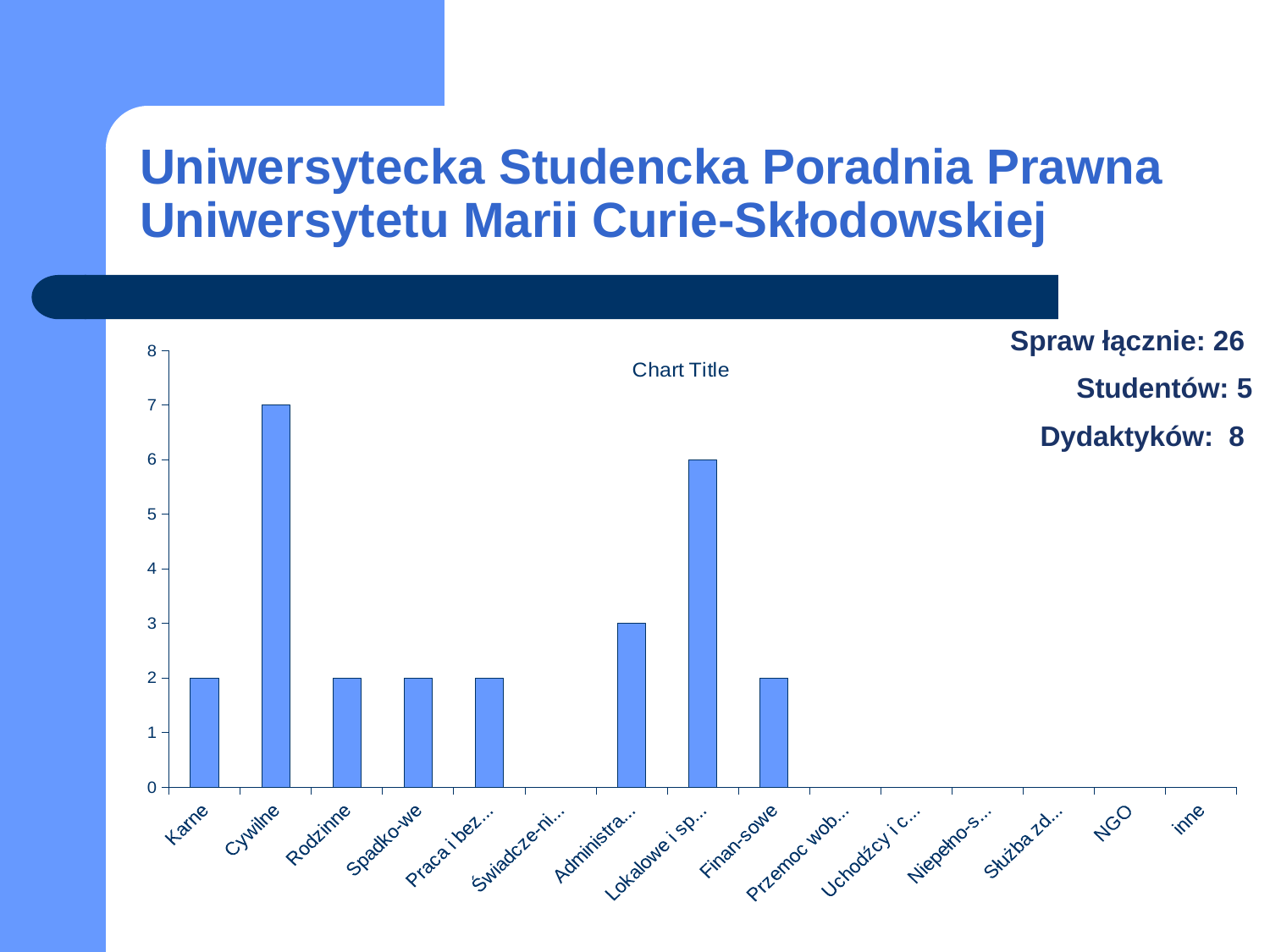
Which is larger, the value for Administra... or the value for Finan-sowe? Administra... What is the difference between the values for Cywilne and Lokalowe i sp...? 1 What is the value for NGO? 0 Which category has the highest value? Cywilne How many categories are shown on the x axis? 15 What is the value for Cywilne? 7 What is the title of the chart? Chart Title What is the value for Administra...? 3 What is the value for Karne? 2 What is the value for Lokalowe i sp...? 6 Is the value for Cywilne greater or less than 5? greater What type of chart is shown on the slide? bar chart